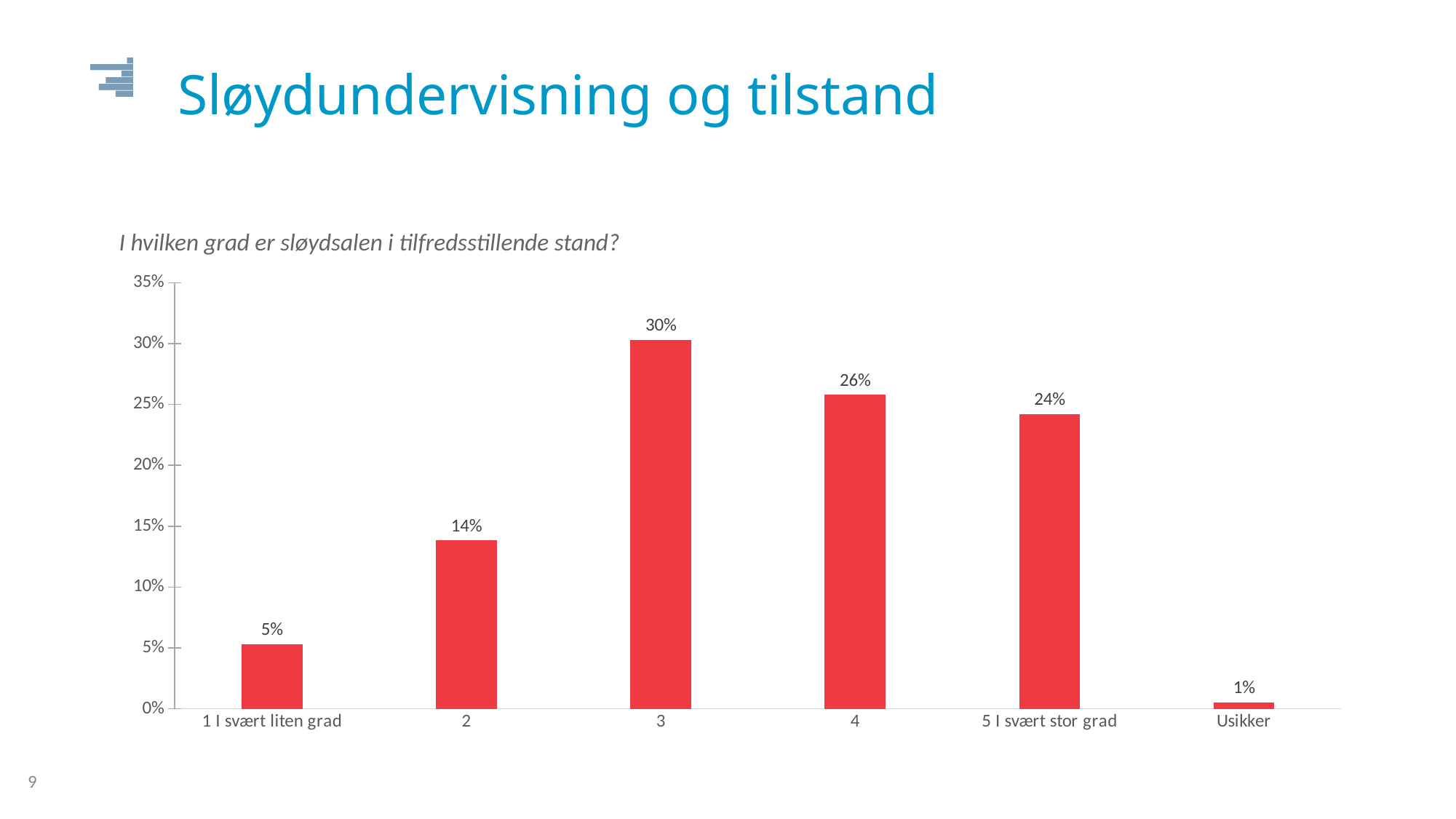
Which category has the highest value? 3 What is the value for '5 I svært stor grad'? 24% Which is larger, the value for category 4 or the value for '5 I svært stor grad'? 4 What is the difference between the values for category 3 and category 2? 16% Which category has the lowest value? Usikker What is the value for category 3? 30% How many categories are shown on the x axis? 6 What is the value for 'Usikker'? 1% What question is the chart about, as shown in the chart title? I hvilken grad er sløydsalen i tilfredsstillende stand? What kind of chart is shown on the slide? bar chart What is the value for '1 I svært liten grad'? 5% Is the value for category 2 greater or less than 15%? less